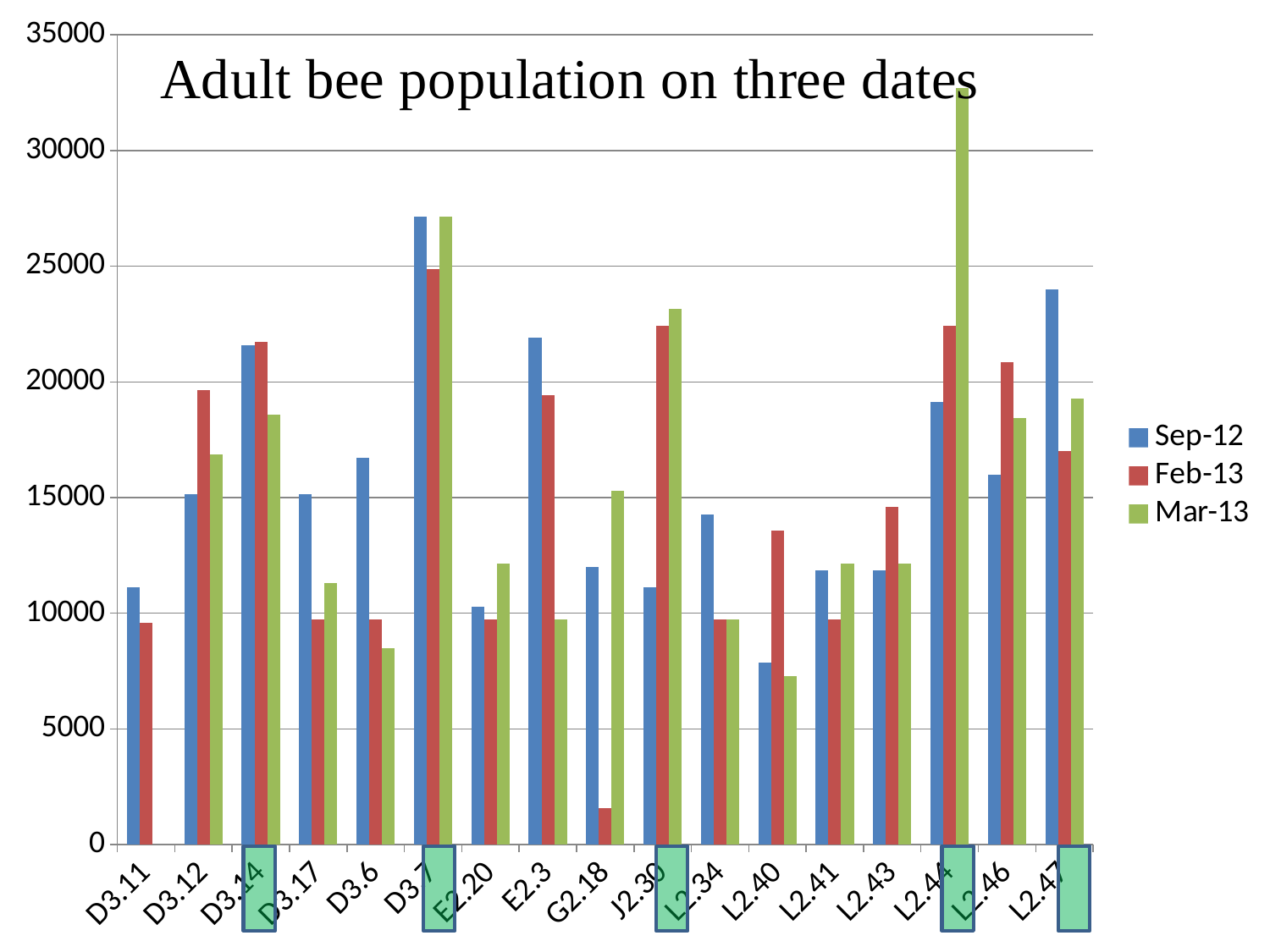
Which colony has the lowest Feb-13 value? G2.18 Is the Mar-13 value for L2.44 greater or less than 30000? greater What kind of chart is shown on the slide? bar chart How many series does the legend list? 3 Which colony has the highest Mar-13 value? L2.44 For D3.12, which is larger: the Sep-12 value or the Feb-13 value? Feb-13 How many colonies (categories) are shown on the x axis? 17 Is the Sep-12 value for L2.47 greater or less than 20000? greater Which colony has the highest Sep-12 value? D3.7 What is the title of the chart? Adult bee population on three dates Is the Feb-13 value for G2.18 greater or less than 5000? less For L2.47, which is larger: the Sep-12 value or the Mar-13 value? Sep-12